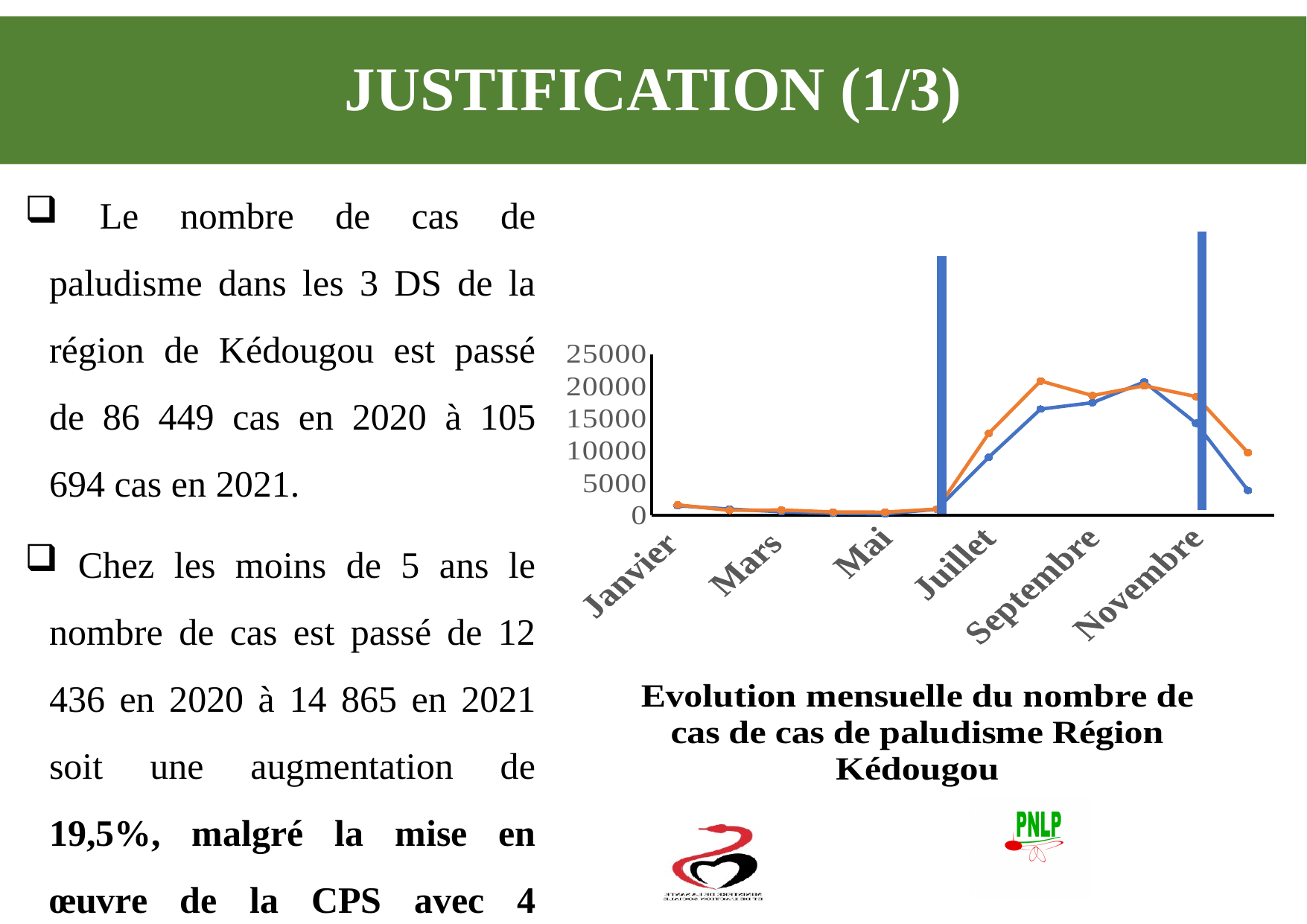
Is the value of the blue line in Juillet greater or less than 10000? less Is the value of the orange line in Janvier greater or less than 5000? less Is the value of the orange line in Juillet greater or less than 10000? greater In Juillet, which line has the higher value, the blue line or the orange line? the orange line How many month labels are shown on the x axis of the chart? 6 Do the values of the blue line rise or fall between Mai and Septembre? rise In Novembre, which line has the higher value, the blue line or the orange line? the orange line What is the highest value shown on the y axis of the chart? 25000 What kind of chart is shown on the slide? line chart Do the values of the orange line rise or fall after Novembre? fall What is the title of the chart? Evolution mensuelle du nombre de cas de cas de paludisme Région Kédougou